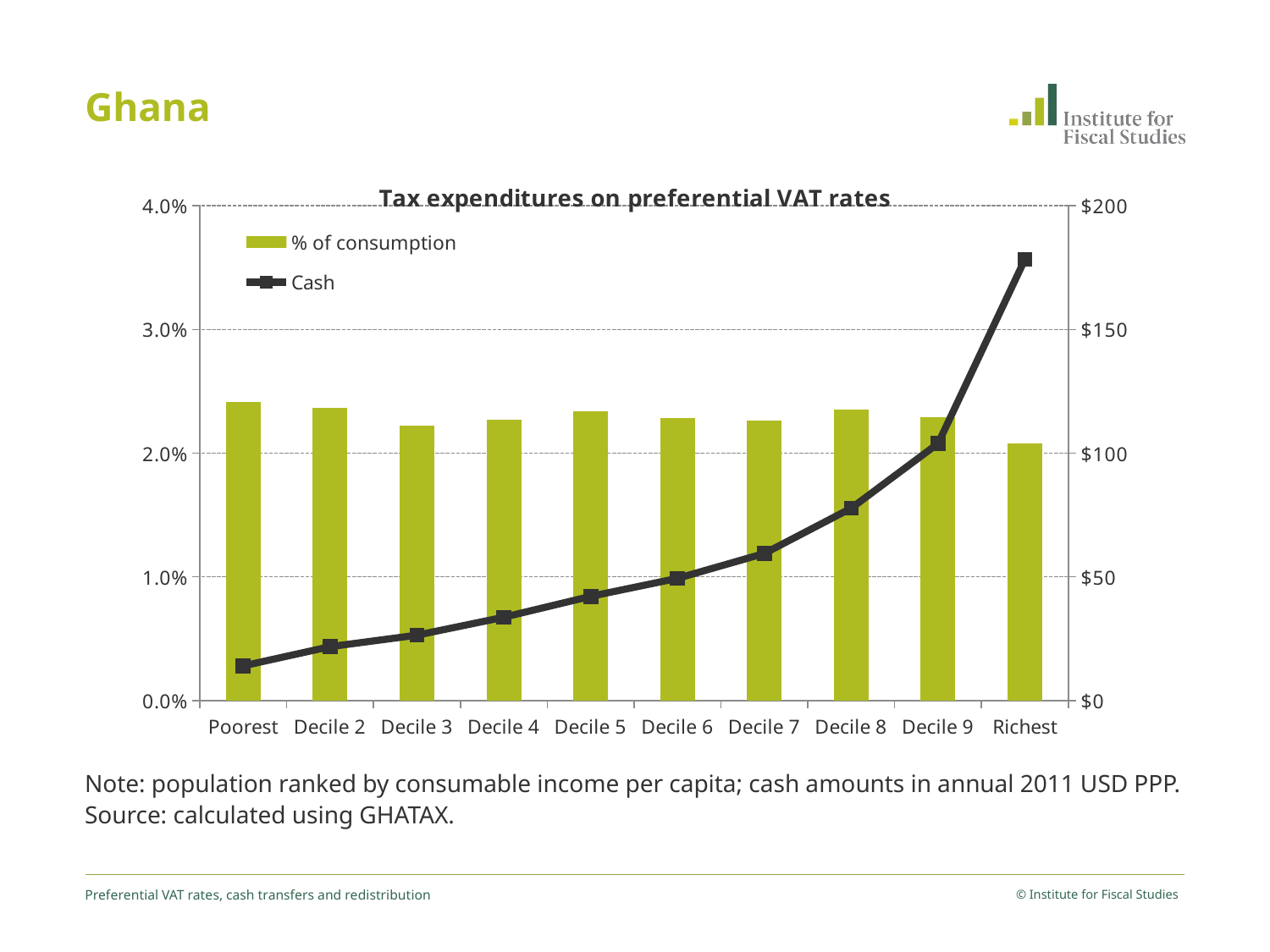
Is the '% of consumption' value for Poorest greater or less than 2.0%? greater Is the Cash value for Poorest greater or less than $50? less Which category has the lowest '% of consumption' bar? Richest Which has the larger '% of consumption' value, Poorest or Richest? Poorest Is the Cash value for Richest greater or less than $150? greater Which category has the highest Cash value? Richest What is the title of the chart? Tax expenditures on preferential VAT rates How many series does the chart legend list? 2 Which category has the lowest Cash value? Poorest How many categories are shown on the x axis of the chart? 10 What type of chart is used to show the '% of consumption' series? Bar chart Does the Cash line rise or fall from Poorest to Richest? Rises